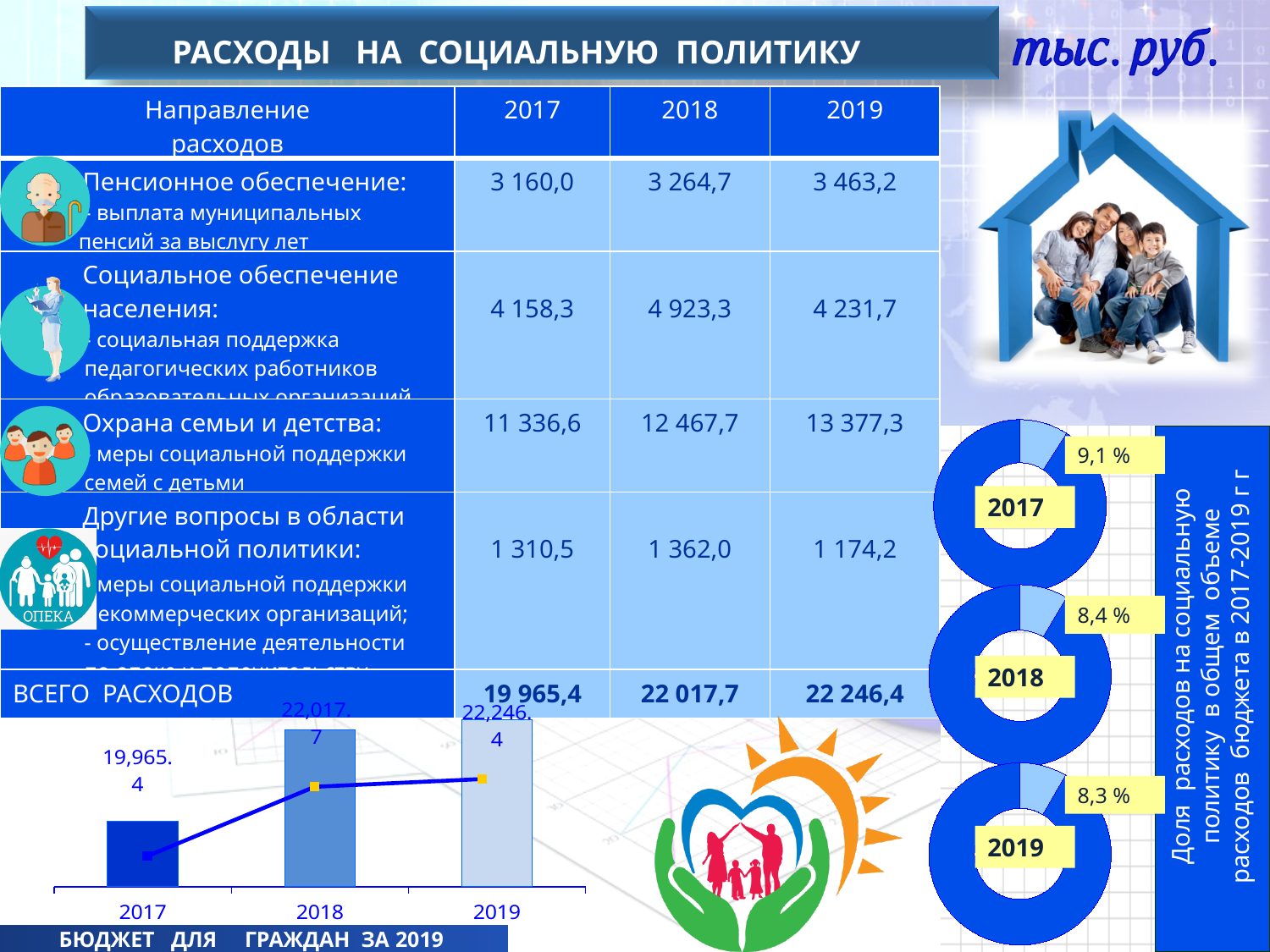
In the bar chart at the bottom left of the slide, which year has the lowest value? 2017 In the bar chart at the bottom left of the slide, do the values rise or fall from 2017 to 2019? rise In the donut charts on the right of the slide, what share is shown for 2019? 8,3 % In the bar chart at the bottom left of the slide, what is the value for 2019? 22,246.4 In the bar chart at the bottom left of the slide, which year has the highest value? 2019 How many years are shown in the bar chart at the bottom left of the slide? 3 In the donut charts on the right of the slide, what share is shown for 2017? 9,1 % In the bar chart at the bottom left of the slide, what is the difference between the values for 2018 and 2017? 2,052.3 What kind of chart is shown at the bottom left of the slide? bar chart In the bar chart at the bottom left of the slide, what is the value for 2017? 19,965.4 In the bar chart at the bottom left of the slide, what is the value for 2018? 22,017.7 In the donut charts on the right of the slide, which year has the largest share? 2017